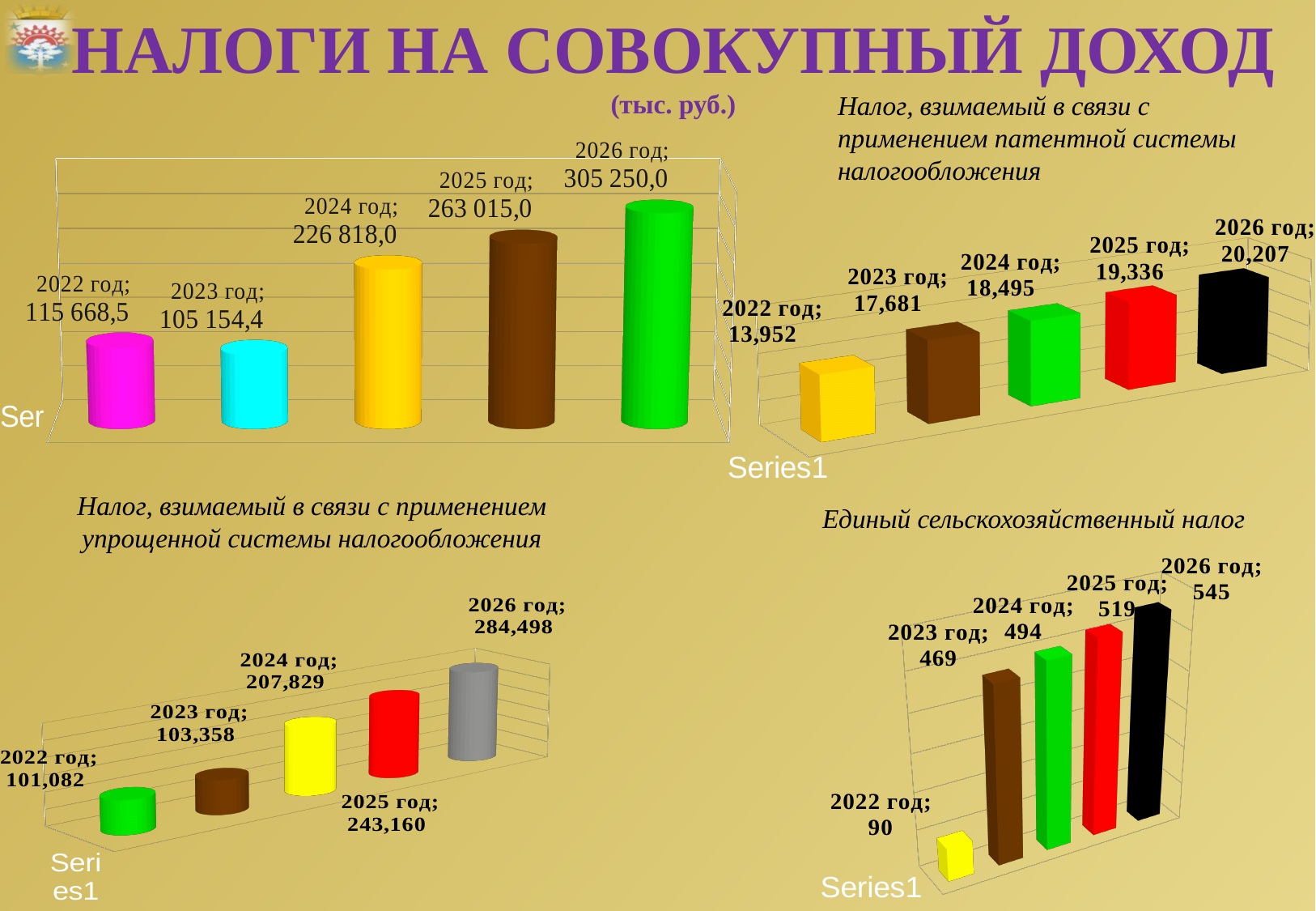
On the chart titled 'Единый сельскохозяйственный налог', what is the value for 2022 год? 90 What kind of chart is the one titled 'Единый сельскохозяйственный налог'? bar chart On the chart titled 'Единый сельскохозяйственный налог', what is the difference between 2026 год and 2025 год? 26 On the chart titled 'Единый сельскохозяйственный налог', which year has the lowest value? 2022 год On the chart titled 'Налог, взимаемый в связи с применением патентной системы налогообложения', do the values rise or fall from 2022 to 2026? rise On the top-left chart (тыс. руб.), which year has the lowest value? 2023 год On the top-left chart (тыс. руб.), what is the value for 2026 год? 305 250,0 On the chart titled 'Налог, взимаемый в связи с применением патентной системы налогообложения', what is the value for 2024 год? 18,495 On the chart titled 'Налог, взимаемый в связи с применением упрощенной системы налогообложения', which is larger, 2022 год or 2023 год? 2023 год On the chart titled 'Налог, взимаемый в связи с применением упрощенной системы налогообложения', what is the value for 2025 год? 243,160 On the top-left chart (тыс. руб.), how many years are plotted? 5 On the chart titled 'Налог, взимаемый в связи с применением патентной системы налогообложения', which year has the highest value? 2026 год